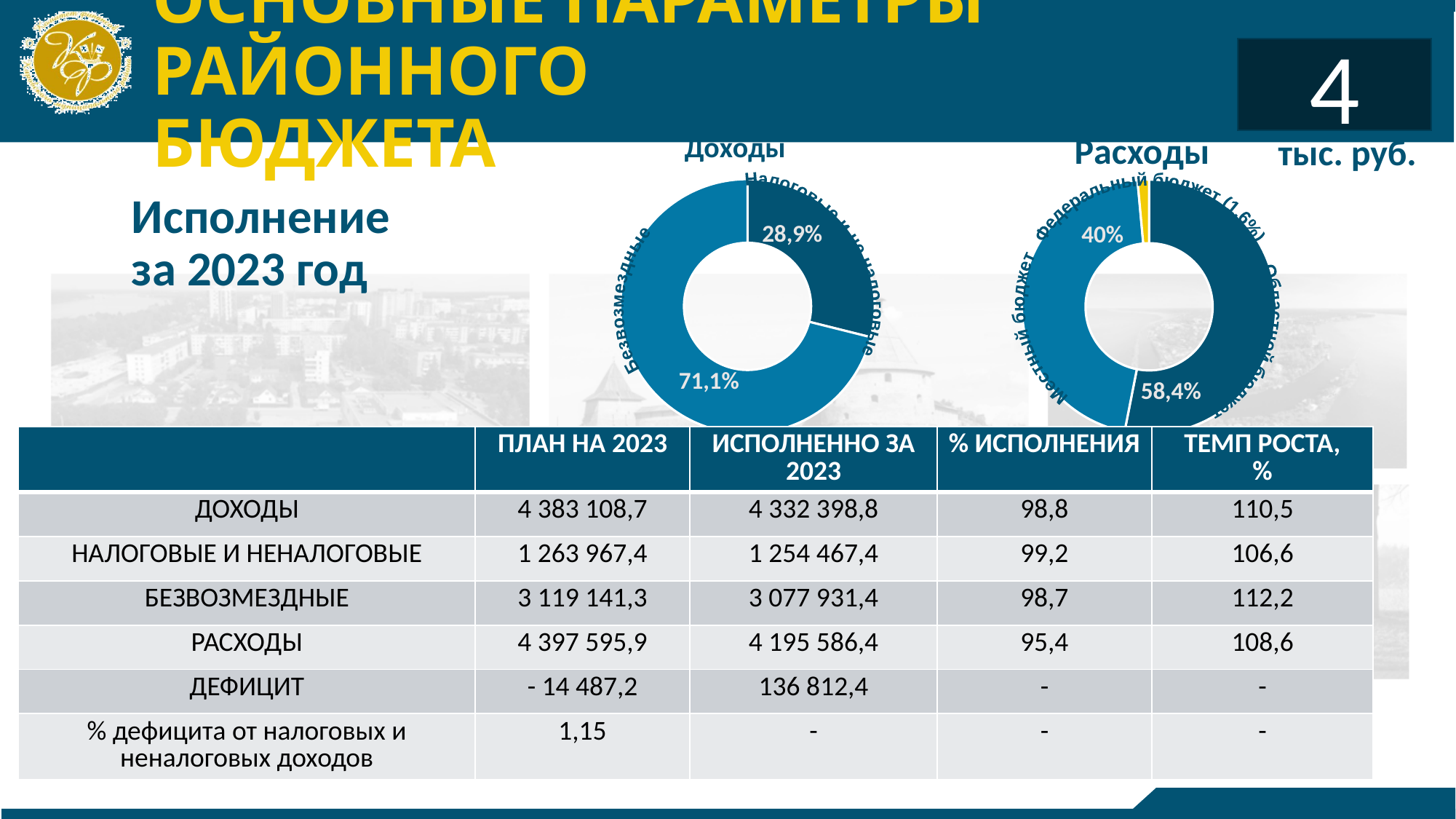
In the Расходы chart, what share is shown for Федеральный бюджет? 1,6% How many slices does the Расходы chart have? 3 In the Расходы chart, what share is shown for Областной бюджет? 58,4% In the Расходы chart, which is larger: Местный бюджет or Областной бюджет? Областной бюджет How many slices does the Доходы chart have? 2 In the Доходы chart, what share is shown for Налоговые и неналоговые? 28,9% In the Расходы chart, which slice is the smallest? Федеральный бюджет In the Расходы chart, what share is shown for Местный бюджет? 40% In the Доходы chart, what share is shown for Безвозмездные? 71,1% What kind of chart is the Доходы chart? Doughnut (pie) chart In the Доходы chart, which slice is the largest? Безвозмездные In the Доходы chart, by how many percentage points does Безвозмездные exceed Налоговые и неналоговые? 42,2 percentage points